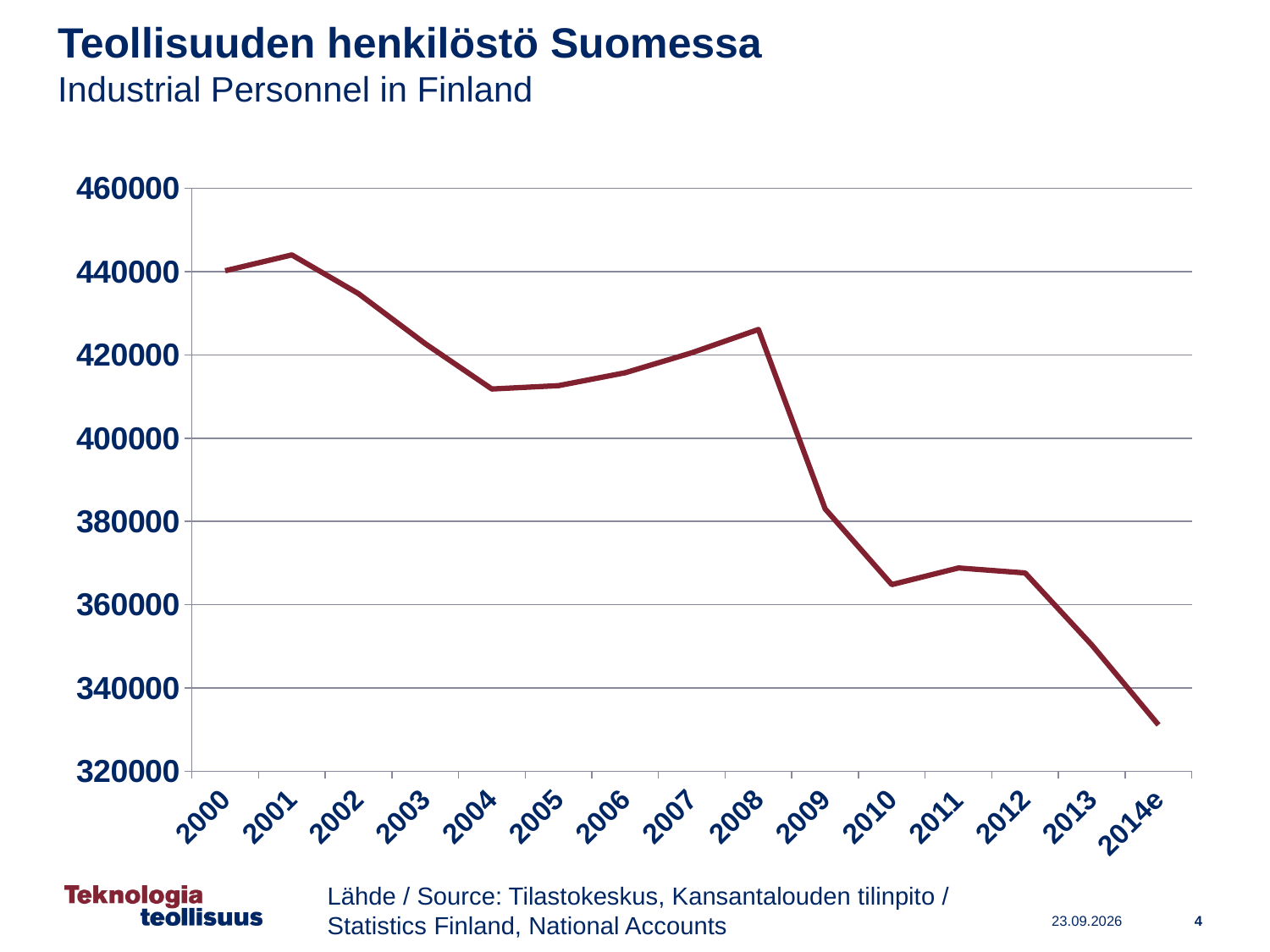
Which year has the lowest industrial personnel value? 2014e What kind of chart is shown on the slide? line chart Which year has the larger value, 2012 or 2013? 2012 Overall, do the values rise or fall from 2000 to 2014e? fall Is the value for 2014e greater or less than 340000? less Is the value for 2002 greater or less than 440000? less Is the value for 2013 greater or less than 360000? less Which year has the larger value, 2008 or 2009? 2008 How many years are plotted along the x axis? 15 Which year has the highest industrial personnel value? 2001 What is the English title of the chart on the slide? Industrial Personnel in Finland